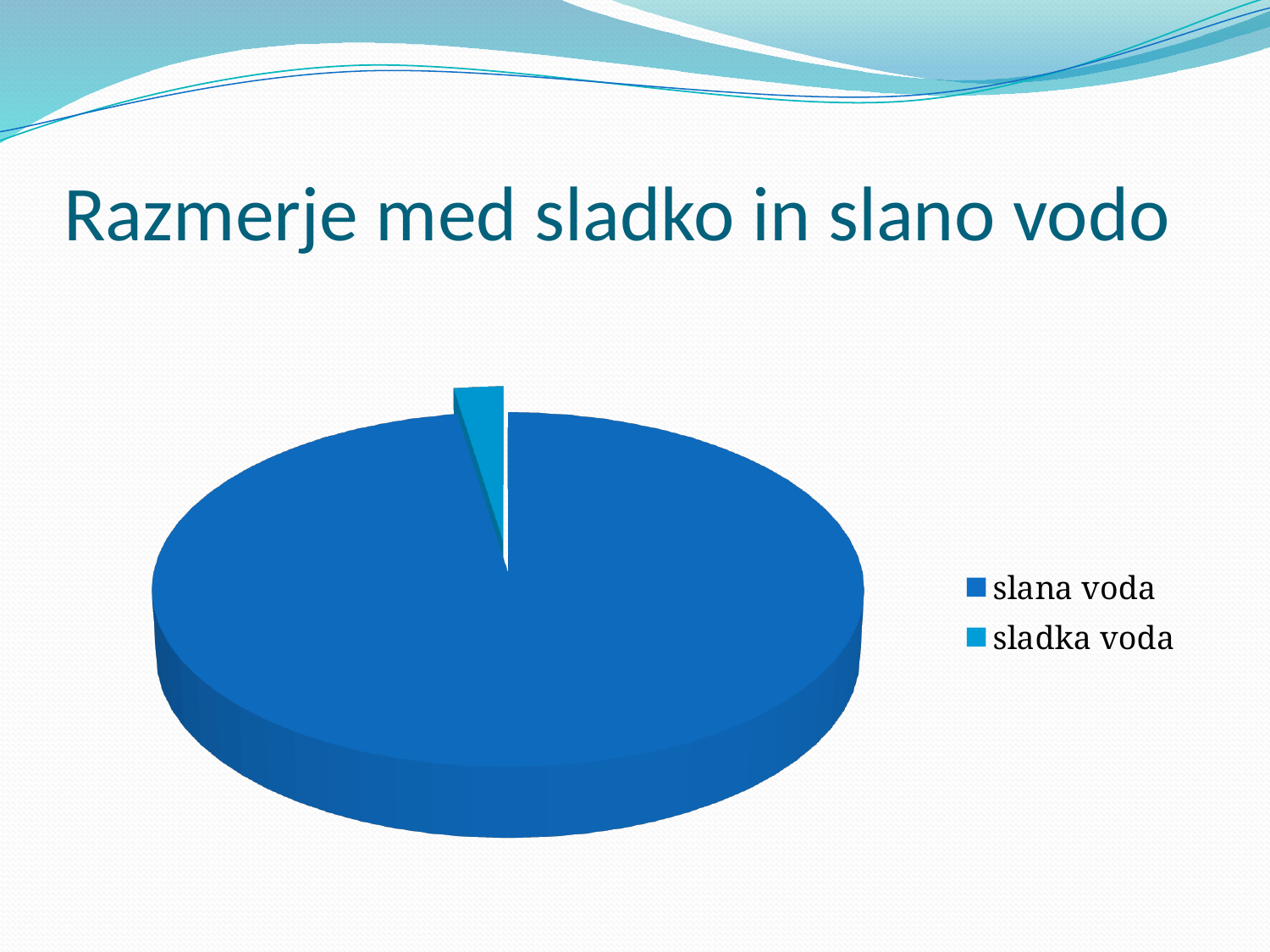
How many slices does the pie chart have? 2 Which is larger, the slice for slana voda or the slice for sladka voda? slana voda Which slice of the pie chart is the largest? slana voda What kind of chart is shown on the slide? pie chart Which slice of the pie chart is the smallest? sladka voda Which legend entry is shown in the lighter blue colour? sladka voda What is the title of the slide containing the pie chart? Razmerje med sladko in slano vodo How many entries does the legend list? 2